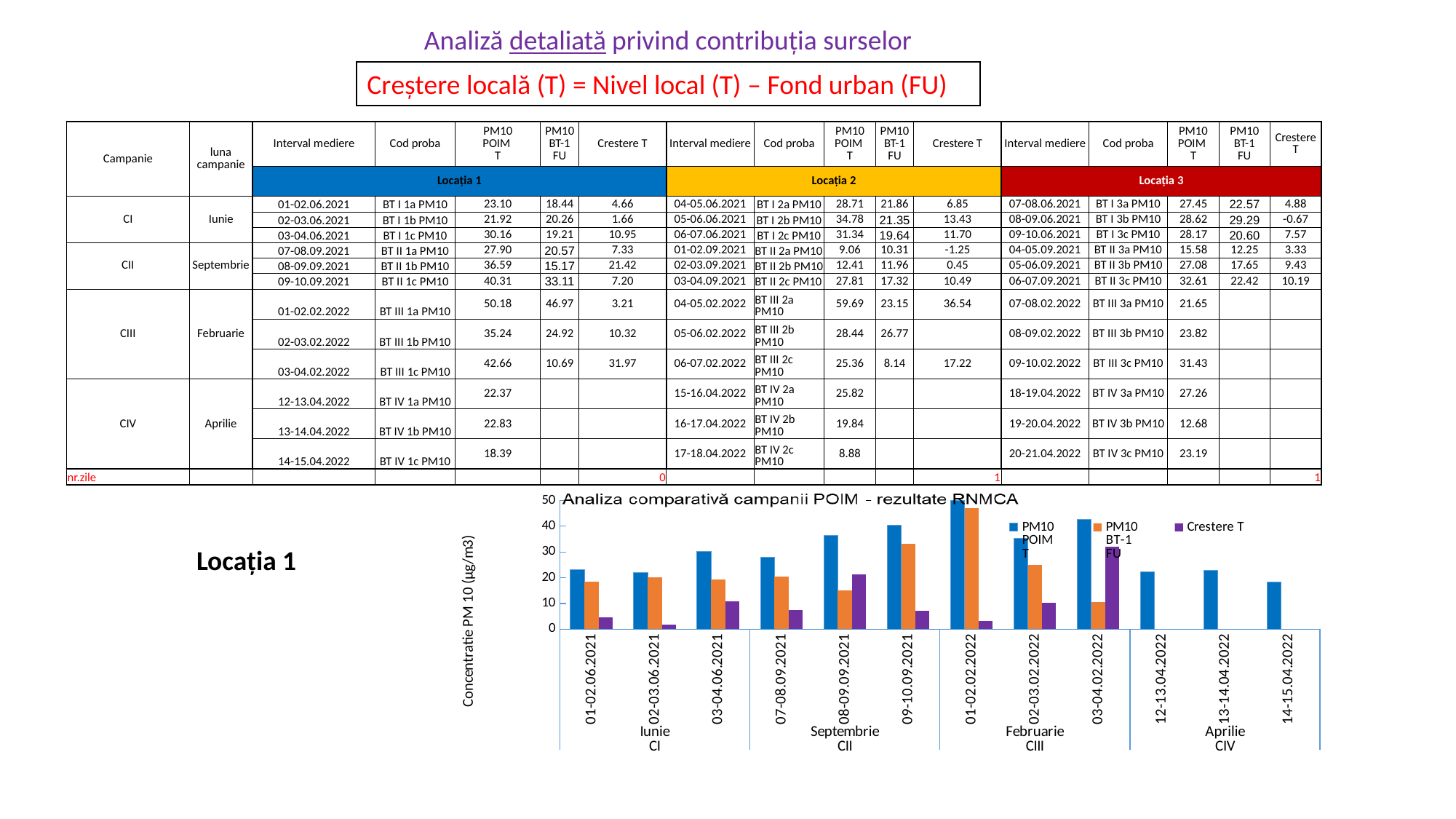
How many series does the chart legend list? 3 Is the PM10 POIM T value for 14-15.04.2022 greater or less than 20? less Which date has the lowest PM10 BT-1 FU value in the chart? 03-04.02.2022 Which date has the highest PM10 POIM T value in the chart? 01-02.02.2022 Which is larger, the PM10 POIM T value for 03-04.06.2021 or for 02-03.06.2021? 03-04.06.2021 Do the PM10 POIM T values rise or fall across the three dates of the Septembrie (CII) campaign? rise How many date categories are plotted along the x axis of the chart? 12 What is the title of the chart's vertical axis? Concentratie PM 10 (µg/m3) Is the PM10 BT-1 FU value for 09-10.09.2021 greater or less than 30? greater What kind of chart is shown on the slide? bar chart Which date has the highest Crestere T value in the chart? 03-04.02.2022 Is the PM10 POIM T value for 08-09.09.2021 greater or less than 30? greater